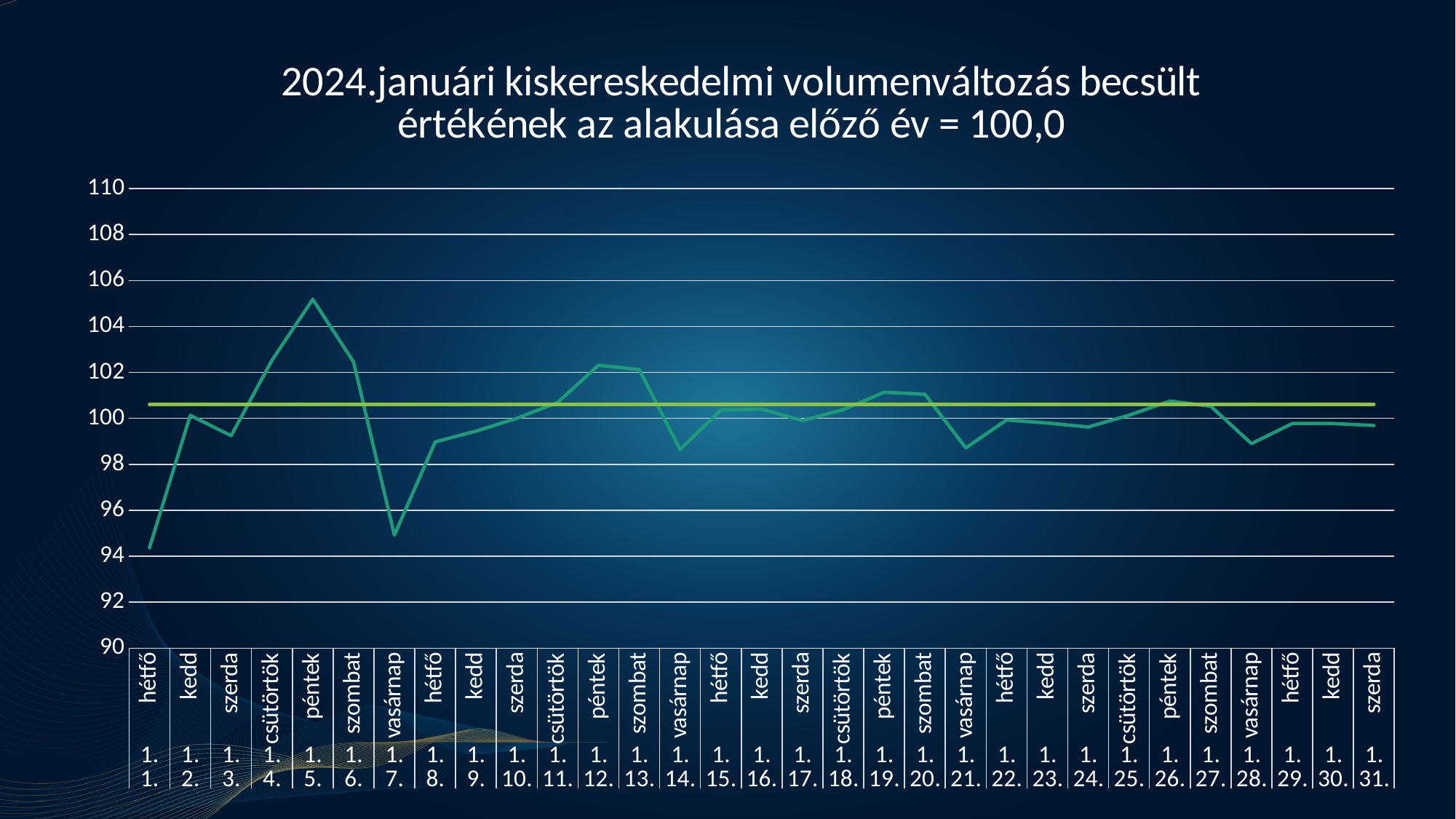
Do the values rise or fall from 1. 3. (szerda) to 1. 5. (péntek)? rise Which day has the larger value, 1. 1. (hétfő) or 1. 2. (kedd)? 1. 2. (kedd) Is the value for 1. 7. (vasárnap) greater or less than 96? less What kind of chart is shown on the slide? line chart On which day does the green line reach its lowest value? 1. 1. (hétfő) Which day has the larger value, 1. 5. (péntek) or 1. 7. (vasárnap)? 1. 5. (péntek) Is the value for 1. 5. (péntek) greater or less than 104? greater Is the value for 1. 14. (vasárnap) greater or less than 100? less On which day does the green line reach its highest value? 1. 5. (péntek) What is the title of the chart? 2024.januári kiskereskedelmi volumenváltozás becsült értékének az alakulása előző év = 100,0 How many days (data points) are plotted along the x axis? 31